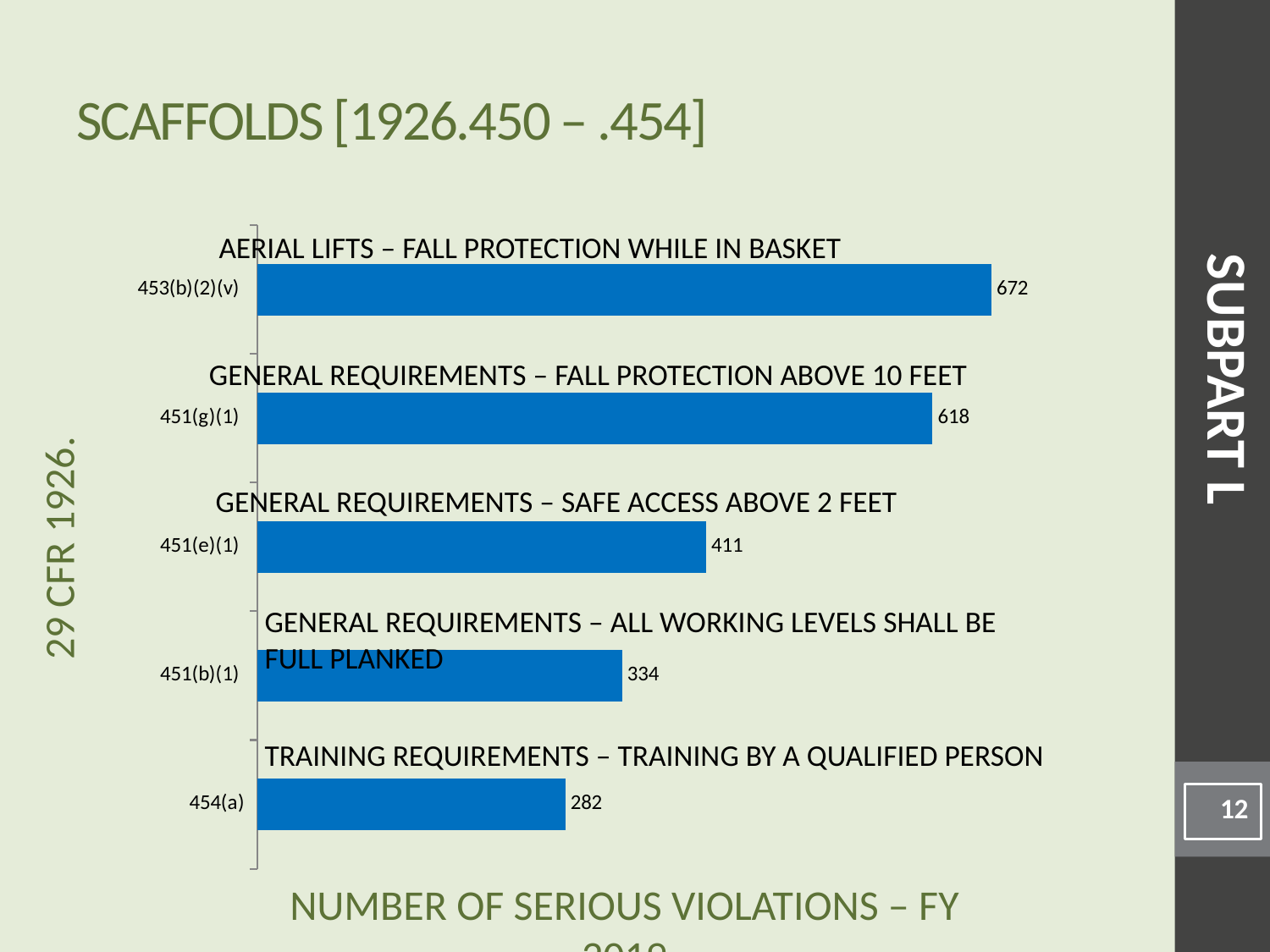
What is the number of serious violations for 451(b)(1)? 334 What is the number of serious violations for 451(e)(1)? 411 How many categories are shown in the chart? 5 Which has more serious violations, 451(b)(1) or 451(e)(1)? 451(e)(1) Which category has the lowest number of serious violations? 454(a) What is the number of serious violations for 453(b)(2)(v)? 672 What type of chart is shown on the slide? Bar chart What is the number of serious violations for 454(a)? 282 Which category has the highest number of serious violations? 453(b)(2)(v) What is the difference between the values for 453(b)(2)(v) and 451(g)(1)? 54 What is the difference between the values for 451(e)(1) and 454(a)? 129 What is the number of serious violations for 451(g)(1)? 618